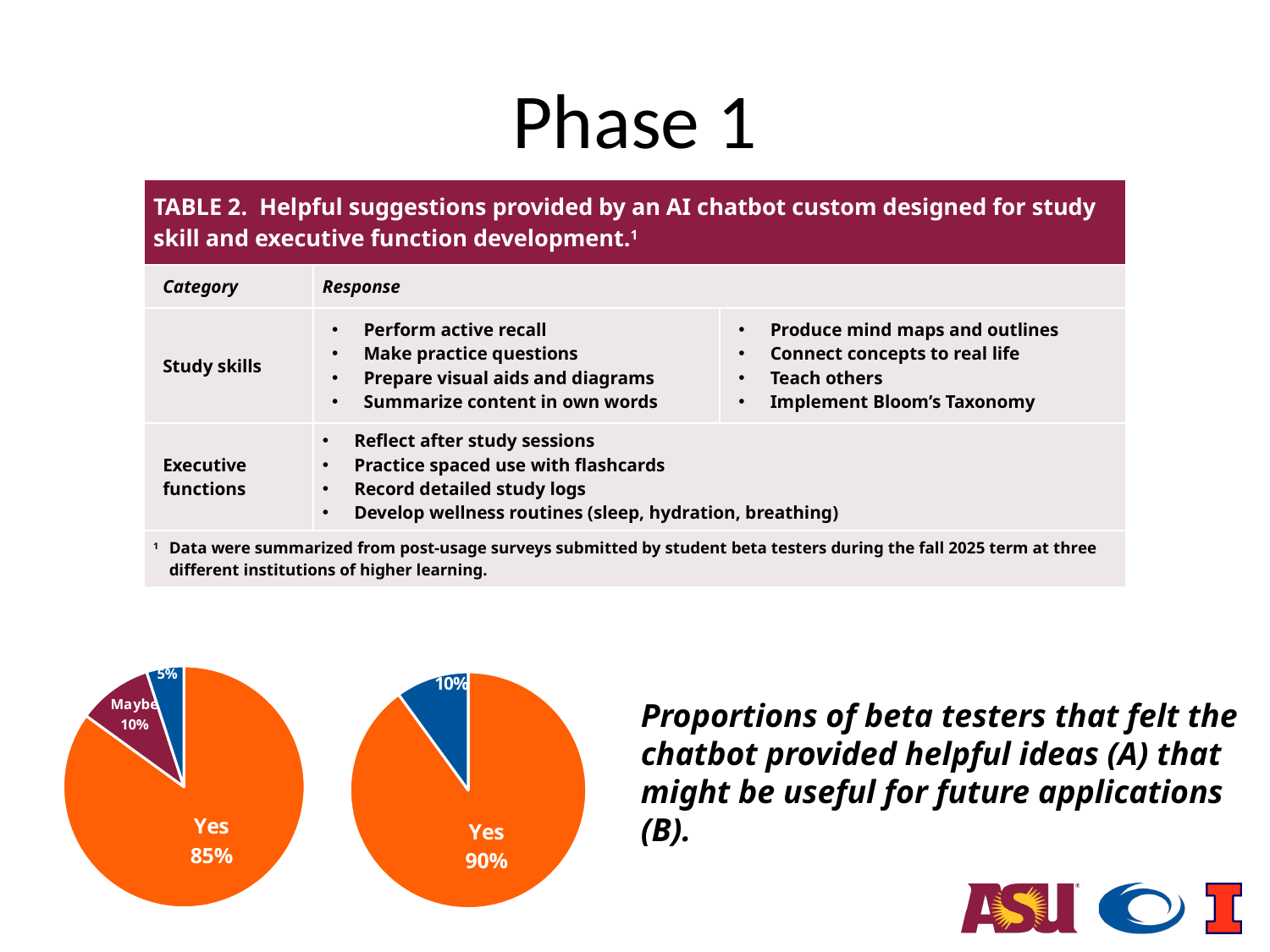
How many slices does the left pie chart have? 3 How many slices does the right pie chart have? 2 In the left pie chart, which response has the largest share? Yes What is the difference between the Yes share in the right pie chart and the Yes share in the left pie chart? 5% In the left pie chart, what is the share of the smallest slice? 5% Which pie chart has the larger Yes share, the left one or the right one? The right one In the left pie chart, what share of beta testers answered Yes? 85% In the right pie chart, what is the share of the smaller slice? 10% In the left pie chart, what share of beta testers answered Maybe? 10% In the left pie chart, what is the difference between the Yes share and the Maybe share? 75% In the right pie chart, what share of beta testers answered Yes? 90% What kind of charts are shown at the bottom of the slide? Pie charts